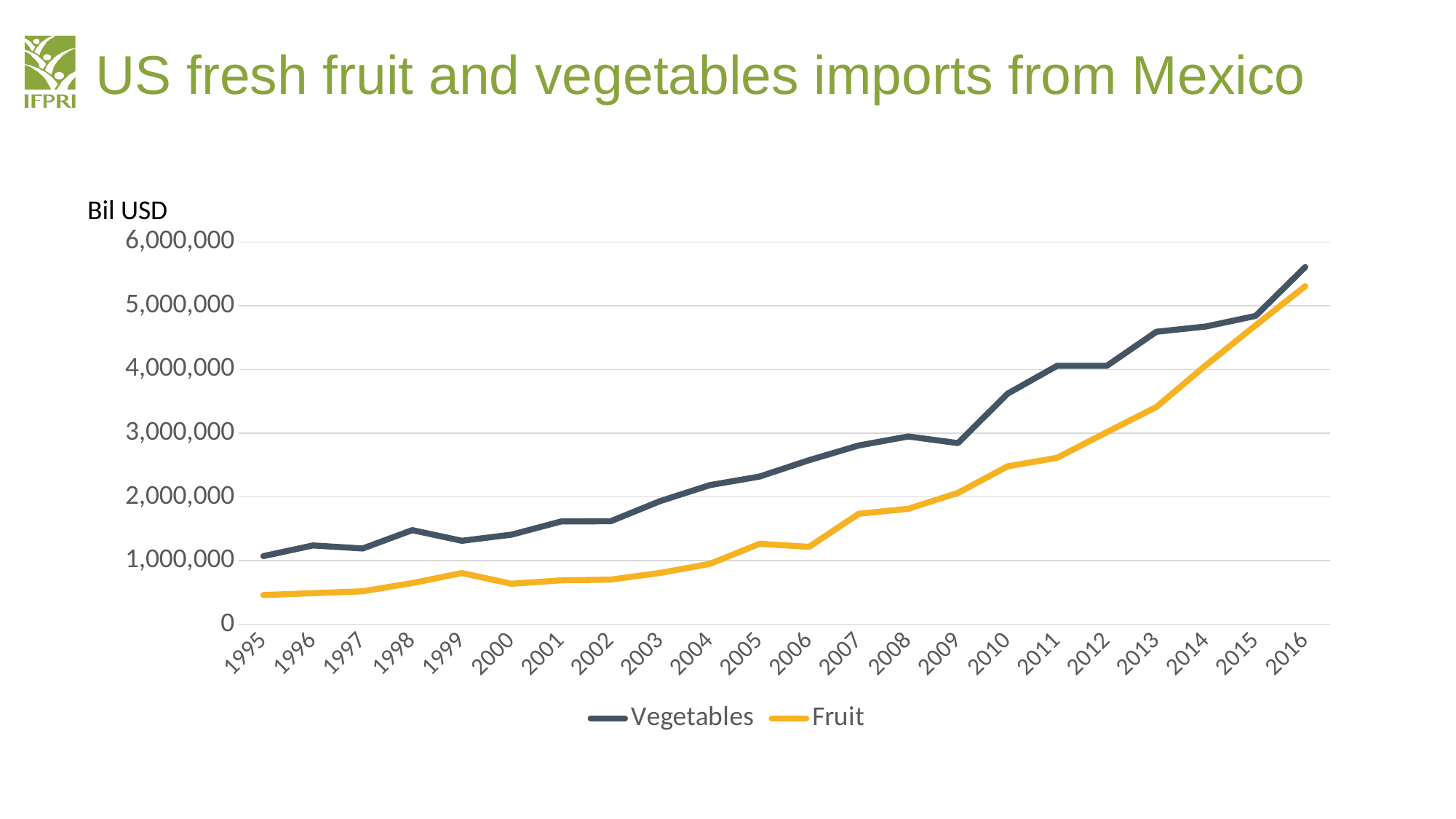
What unit label is shown above the y axis? Bil USD How many series does the legend list? 2 In 2005, which series has the larger value, Vegetables or Fruit? Vegetables Is the value for Fruit in 1995 greater or less than 1,000,000? less What kind of chart is shown on the slide? line chart In which year is the Vegetables series at its highest? 2016 In which year is the Fruit series at its lowest? 1995 Is the value for Vegetables in 2013 greater or less than 4,000,000? greater Do the Fruit values generally rise or fall from 1995 to 2016? rise How many years are plotted along the x axis? 22 Is the value for Vegetables in 2016 greater or less than 5,000,000? greater